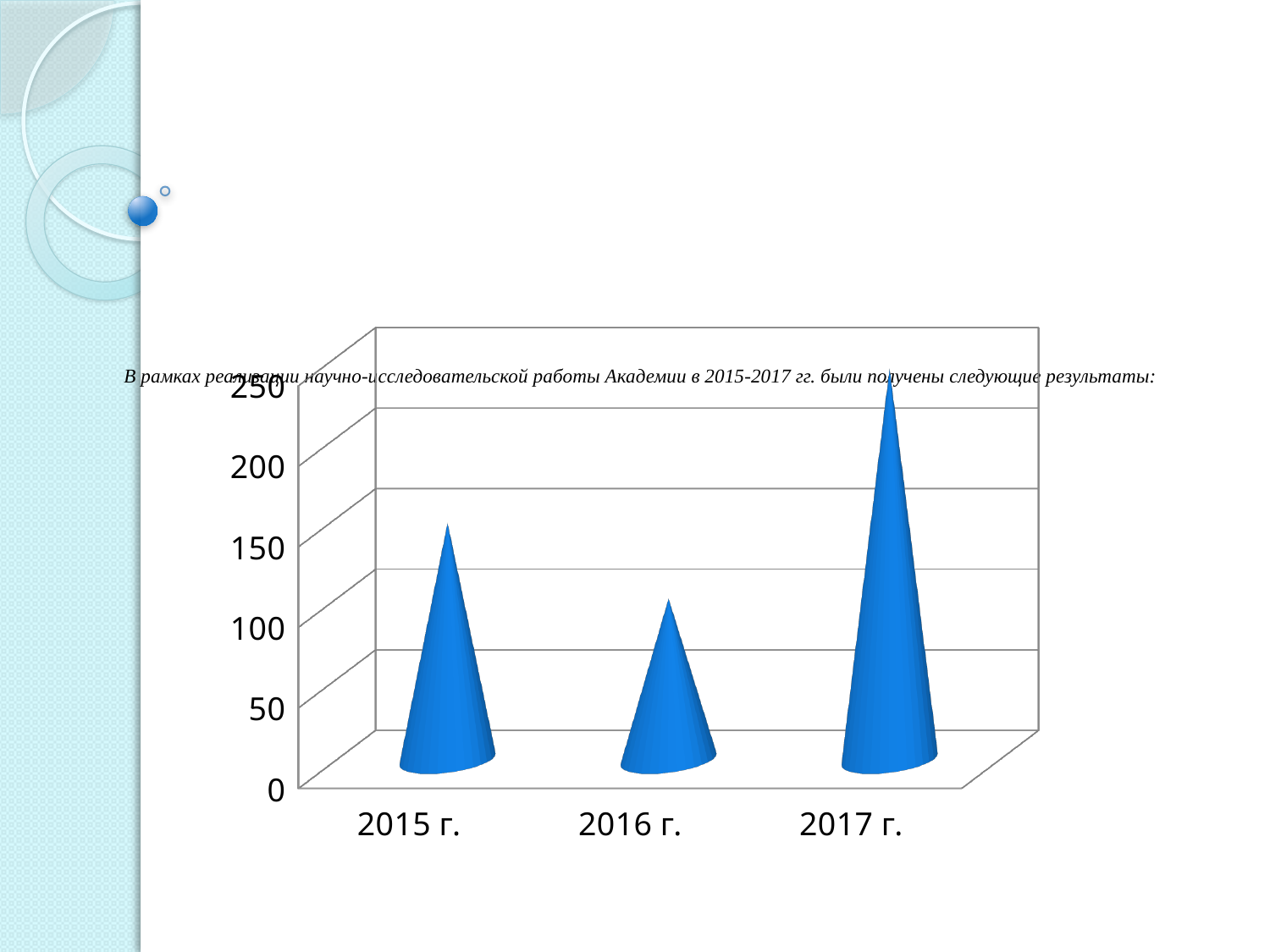
Which is larger, the value for 2017 г. or the value for 2015 г.? 2017 г. Which year has the highest value in the chart? 2017 г. What is the highest value shown on the vertical axis of the chart? 250 Which year has the lowest value in the chart? 2016 г. Is the value for 2016 г. greater or less than 50? greater Does the value rise or fall from 2015 г. to 2016 г.? falls How many categories are shown on the x axis of the chart? 3 Does the value rise or fall from 2016 г. to 2017 г.? rises Is the value for 2017 г. greater or less than 200? greater Which is larger, the value for 2015 г. or the value for 2016 г.? 2015 г. What kind of chart is shown on the slide? bar chart Is the value for 2015 г. greater or less than 100? greater